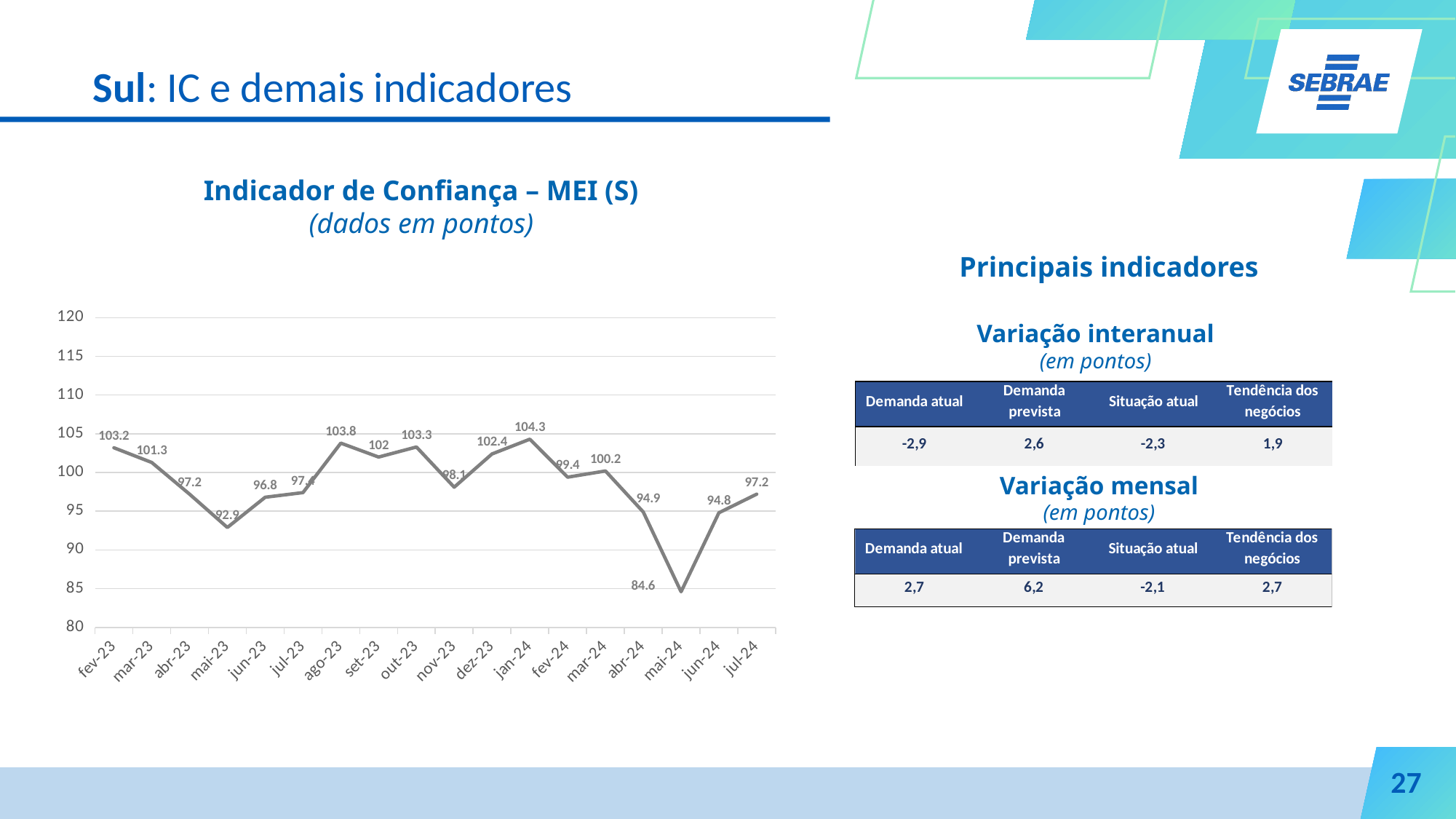
What is the value of the Indicador de Confiança for jul-24? 97.2 What is the value of the Indicador de Confiança for jan-24? 104.3 Is the value for mai-23 greater or less than 95? less Which month has the lowest value on the chart? mai-24 Which is larger, the value for ago-23 or the value for set-23? ago-23 What is the difference between the values for jan-24 and mai-24? 19.7 Which month has the highest value on the chart? jan-24 What is the value of the Indicador de Confiança for fev-23? 103.2 What is the value of the Indicador de Confiança for mai-24? 84.6 Does the value rise or fall from mai-24 to jul-24? rise How many months are plotted on the chart? 18 What kind of chart is shown on the slide? line chart